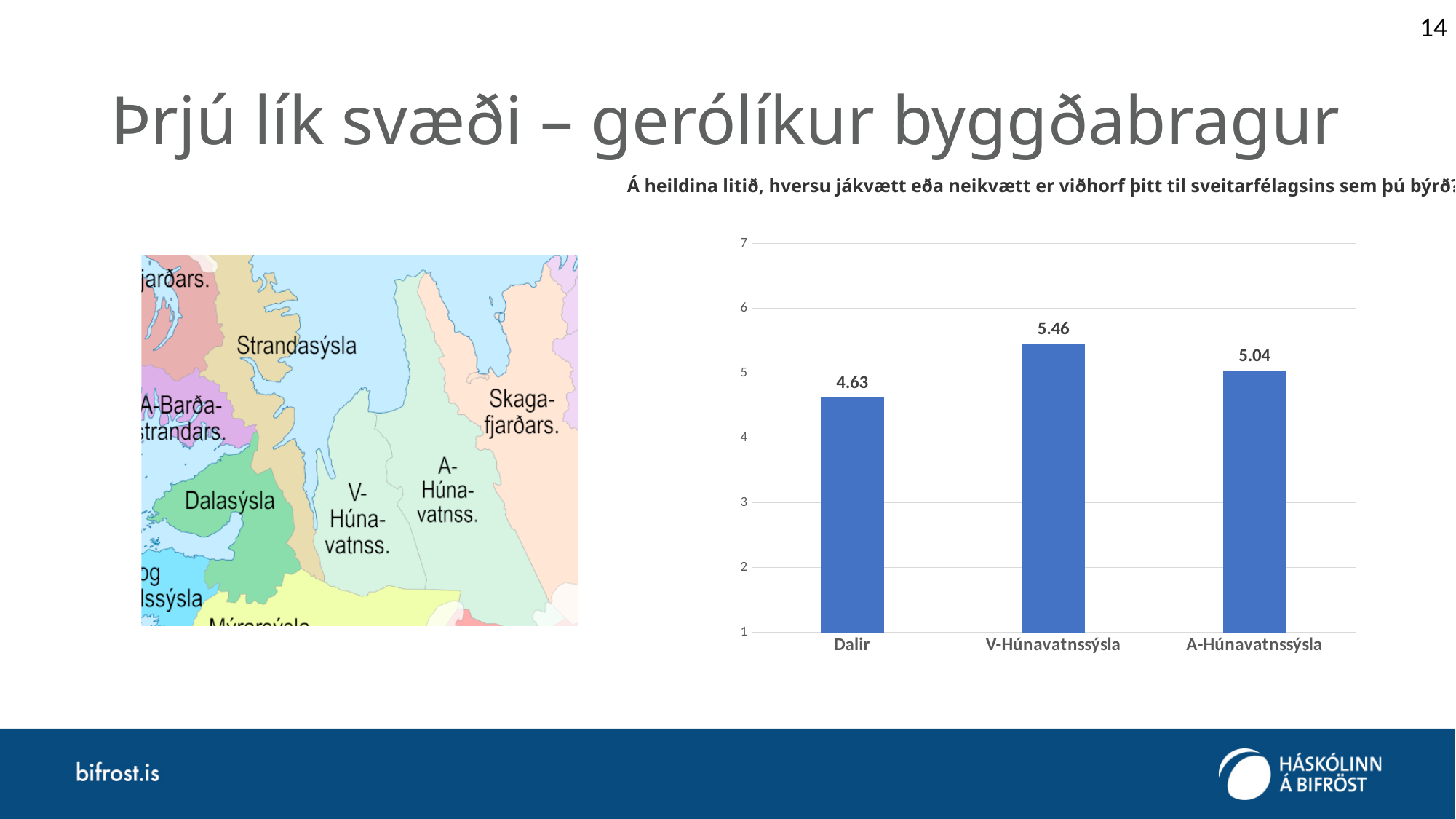
What kind of chart is shown on the slide? bar chart What is the title of the chart? Á heildina litið, hversu jákvætt eða neikvætt er viðhorf þitt til sveitarfélagsins sem þú býrð? Is the value for Dalir greater or less than 5? less Which category has the lowest value? Dalir Which category has the highest value? V-Húnavatnssýsla How many categories are shown in the chart? 3 What is the value for Dalir? 4.63 Which is larger, the value for A-Húnavatnssýsla or the value for Dalir? A-Húnavatnssýsla What is the difference between the values for V-Húnavatnssýsla and Dalir? 0.83 What is the value for A-Húnavatnssýsla? 5.04 What is the difference between the values for V-Húnavatnssýsla and A-Húnavatnssýsla? 0.42 What is the value for V-Húnavatnssýsla? 5.46